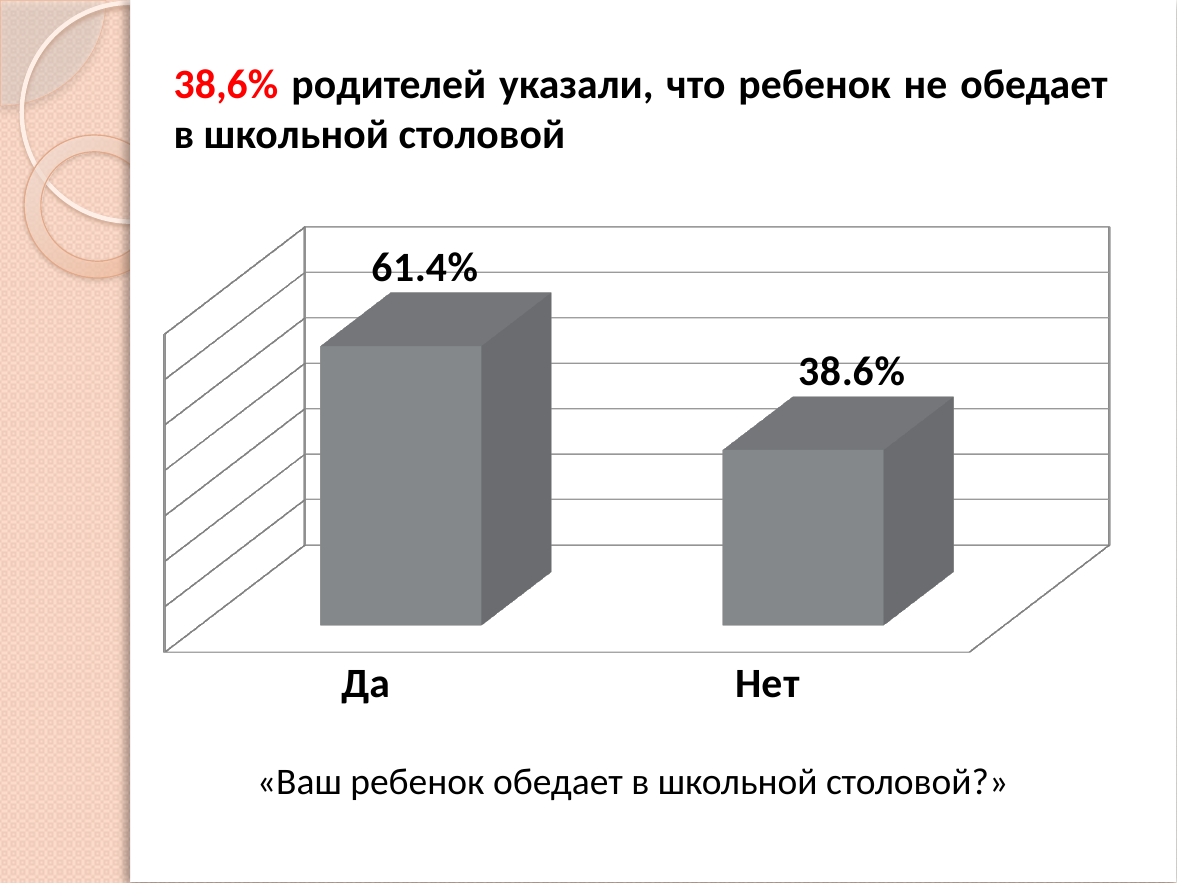
Which category has the highest value? Да Which is larger, the value for "Да" or the value for "Нет"? Да How many categories are shown in the chart? 2 Do the values rise or fall from left to right along the x axis? fall What is the value for "Да"? 61.4% Which category has the lowest value? Нет What is the difference between the values for "Да" and "Нет"? 22.8% What is the value for "Нет"? 38.6% What question is written below the chart? «Ваш ребенок обедает в школьной столовой?» What colour are the bars in the chart? grey What kind of chart is shown on the slide? bar chart What is the total of the two values shown in the chart? 100%